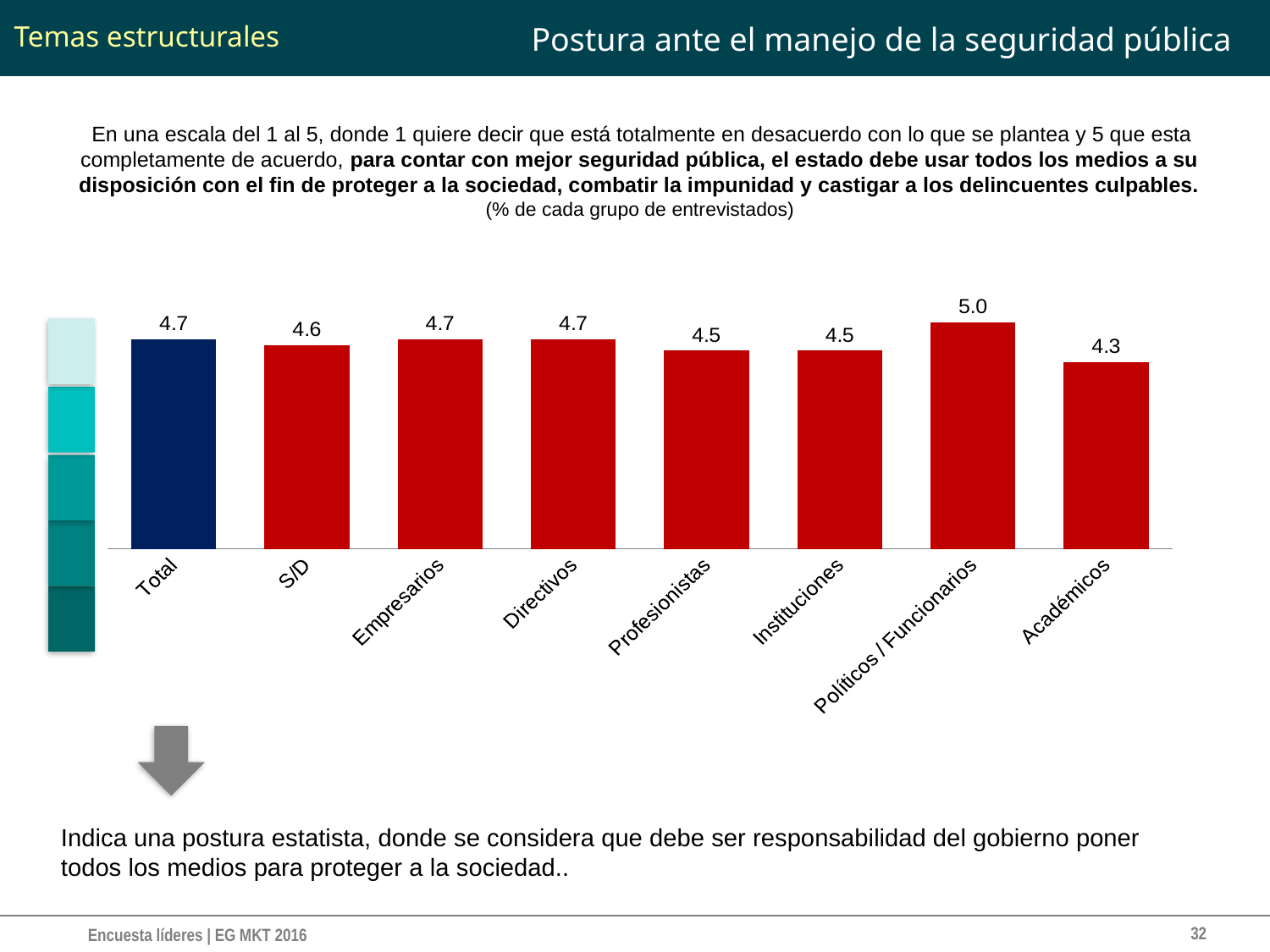
What is the value for Políticos / Funcionarios? 5.0 What is the difference between the values for Políticos / Funcionarios and Académicos? 0.7 What is the value for Instituciones? 4.5 Which category has the highest value? Políticos / Funcionarios How many categories are shown on the x axis? 8 What is the value for Académicos? 4.3 Which category has the lowest value? Académicos What colour is the bar for Total? Dark blue What kind of chart is shown on the slide? Bar chart What is the value for S/D? 4.6 What is the value for Total? 4.7 Which is larger, the value for Empresarios or the value for Profesionistas? Empresarios